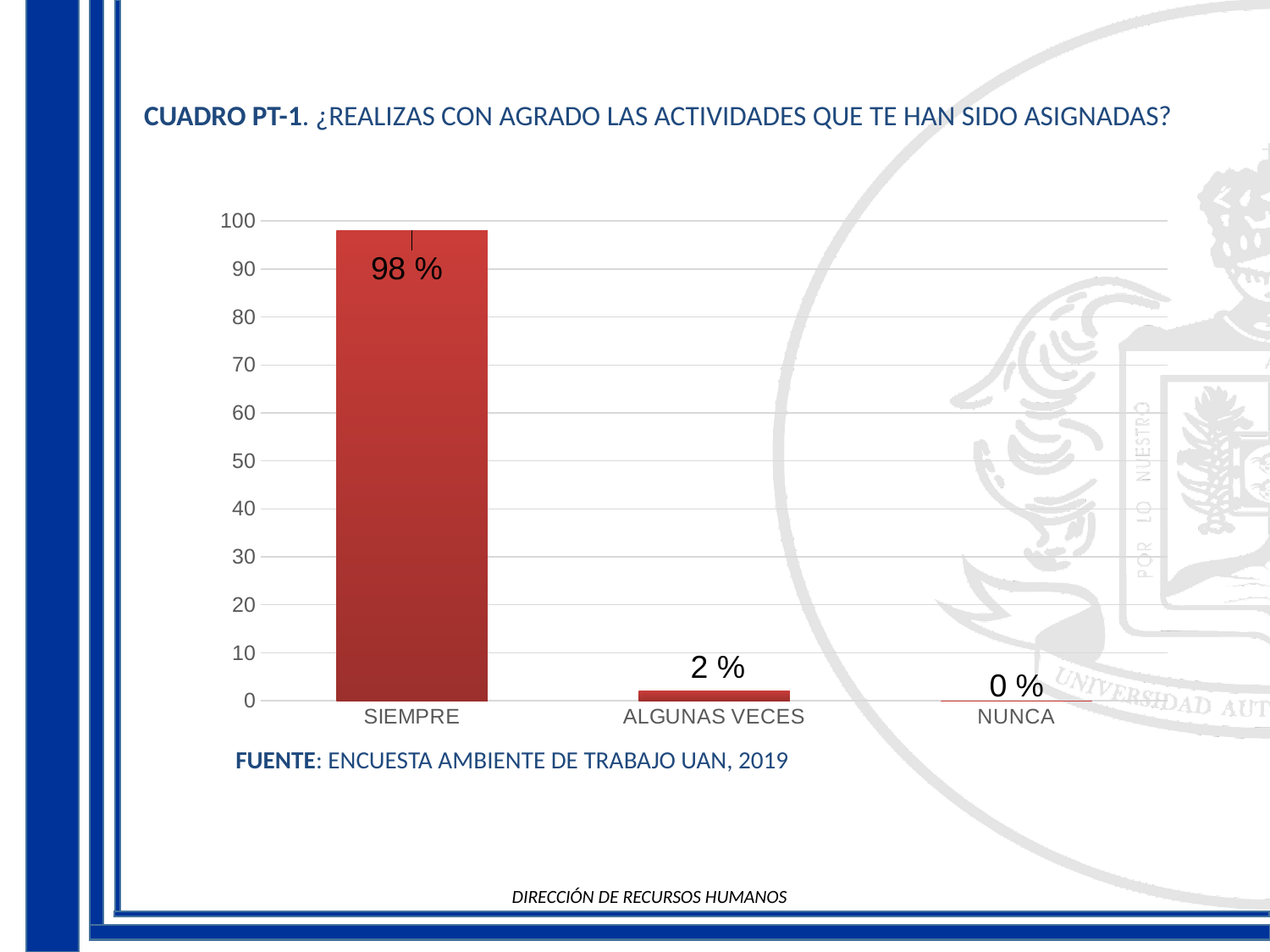
What is the value for ALGUNAS VECES? 2 % What source is cited below the chart? ENCUESTA AMBIENTE DE TRABAJO UAN, 2019 How many categories are shown on the x axis? 3 What is the difference between the values for SIEMPRE and ALGUNAS VECES? 96 % Do the values rise or fall from left to right along the x axis? fall What is the value for NUNCA? 0 % Which is larger, the value for ALGUNAS VECES or the value for NUNCA? ALGUNAS VECES Which category has the highest value? SIEMPRE Which category has the lowest value? NUNCA What kind of chart is shown on the slide? bar chart Is the value for SIEMPRE greater or less than 90? greater What is the value for SIEMPRE? 98 %